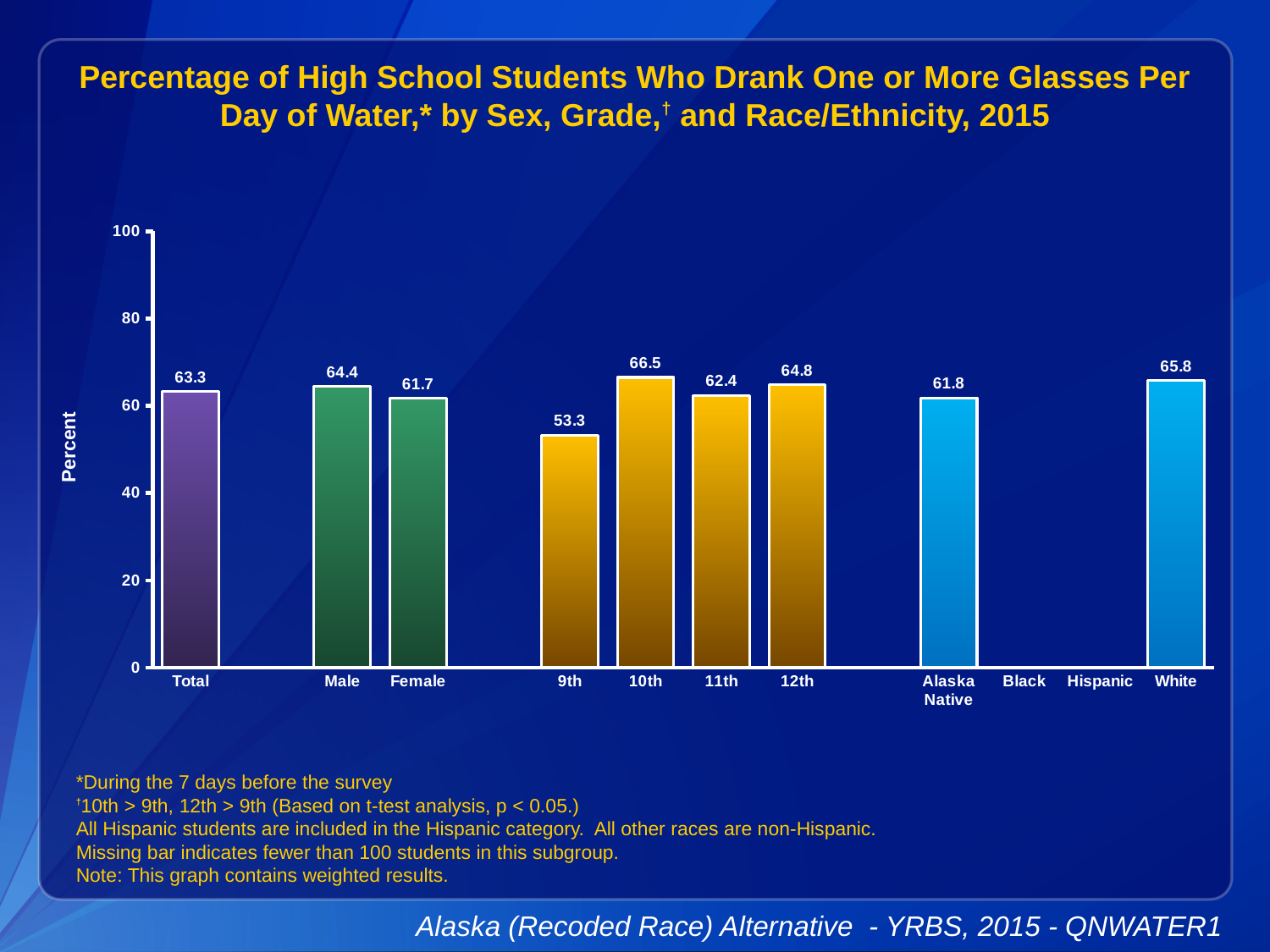
What is the value for 9th grade? 53.3 What is the value for White? 65.8 Which category has the lowest value among the bars shown? 9th What is the difference between the values for Male and Female? 2.7 Is the value for Alaska Native greater or less than 60? greater What is the difference between the values for 10th and 9th grade? 13.2 Which category has the highest value? 10th Which is larger, the value for 12th grade or the value for 11th grade? 12th What is the value for Female? 61.7 What kind of chart is shown on the slide? bar chart What is the value for Total? 63.3 Which race/ethnicity categories have no bar shown? Black and Hispanic